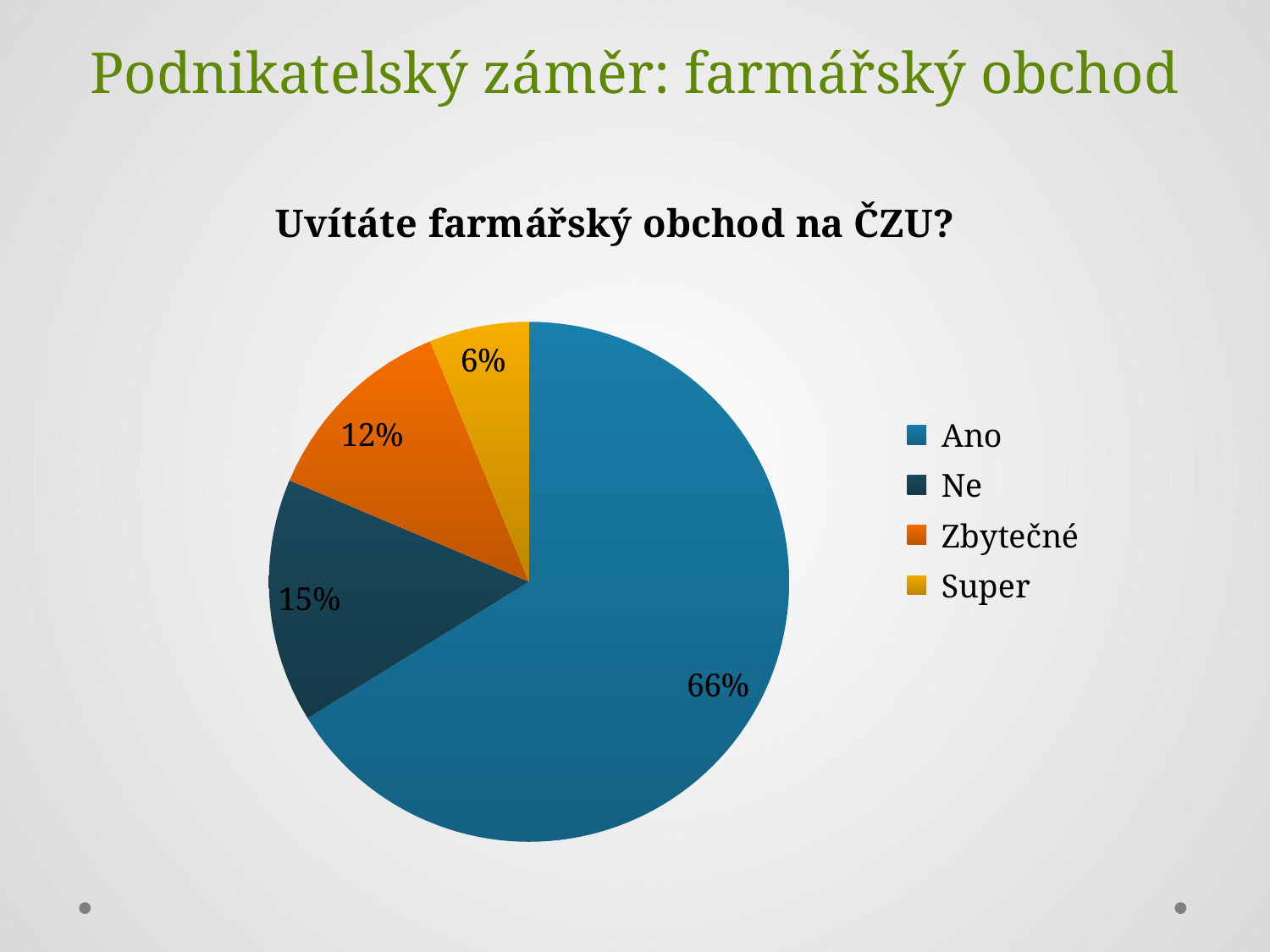
What colour is the slice for "Super"? yellow What is the title of the chart? Uvítáte farmářský obchod na ČZU? What percentage of the pie is labelled for "Ano"? 66% Which is larger, the share for "Ne" or the share for "Super"? Ne What type of chart is shown on the slide? pie chart How many categories does the legend list? 4 What percentage of the pie is labelled for "Super"? 6% What percentage of the pie is labelled for "Ne"? 15% Which category has the smallest slice of the pie? Super What percentage of the pie is labelled for "Zbytečné"? 12% What is the difference in percentage points between "Ne" and "Zbytečné"? 3 Which category has the largest slice of the pie? Ano